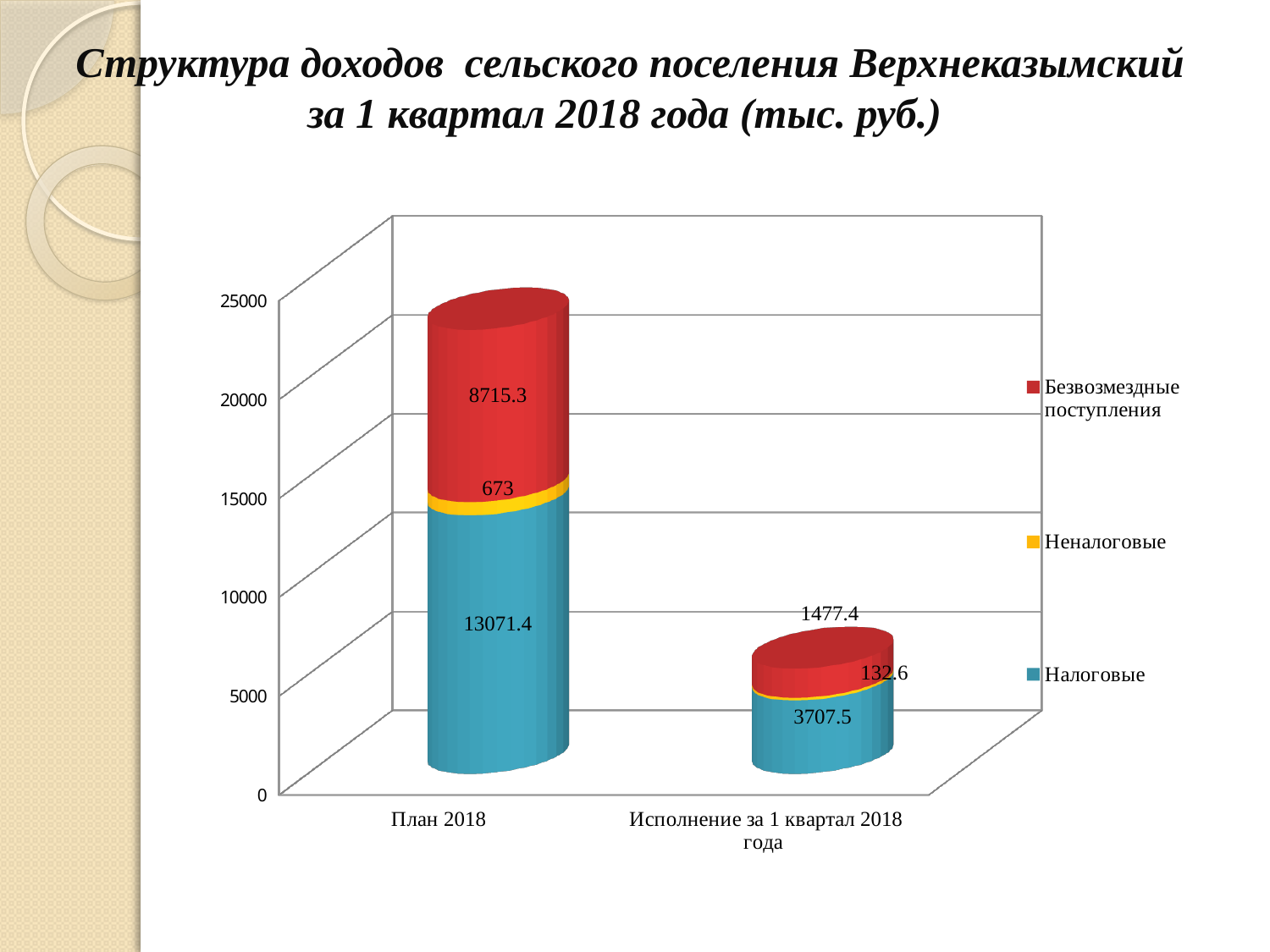
Which series has the smallest value in the Исполнение за 1 квартал 2018 года bar? Неналоговые What is the value of Безвозмездные поступления for Исполнение за 1 квартал 2018 года? 1477.4 What is the value of Налоговые for План 2018? 13071.4 Which series has the largest value in the План 2018 bar? Налоговые What kind of chart is shown on the slide? Stacked bar chart What is the total of the stacked bar for План 2018? 22459.7 What is the total of the stacked bar for Исполнение за 1 квартал 2018 года? 5317.5 What is the difference between the Налоговые values for План 2018 and Исполнение за 1 квартал 2018 года? 9363.9 What is the value of Неналоговые for План 2018? 673 Which is larger: Безвозмездные поступления for План 2018 or Налоговые for Исполнение за 1 квартал 2018 года? Безвозмездные поступления for План 2018 What is the value of Неналоговые for Исполнение за 1 квартал 2018 года? 132.6 How many series does the legend list? 3